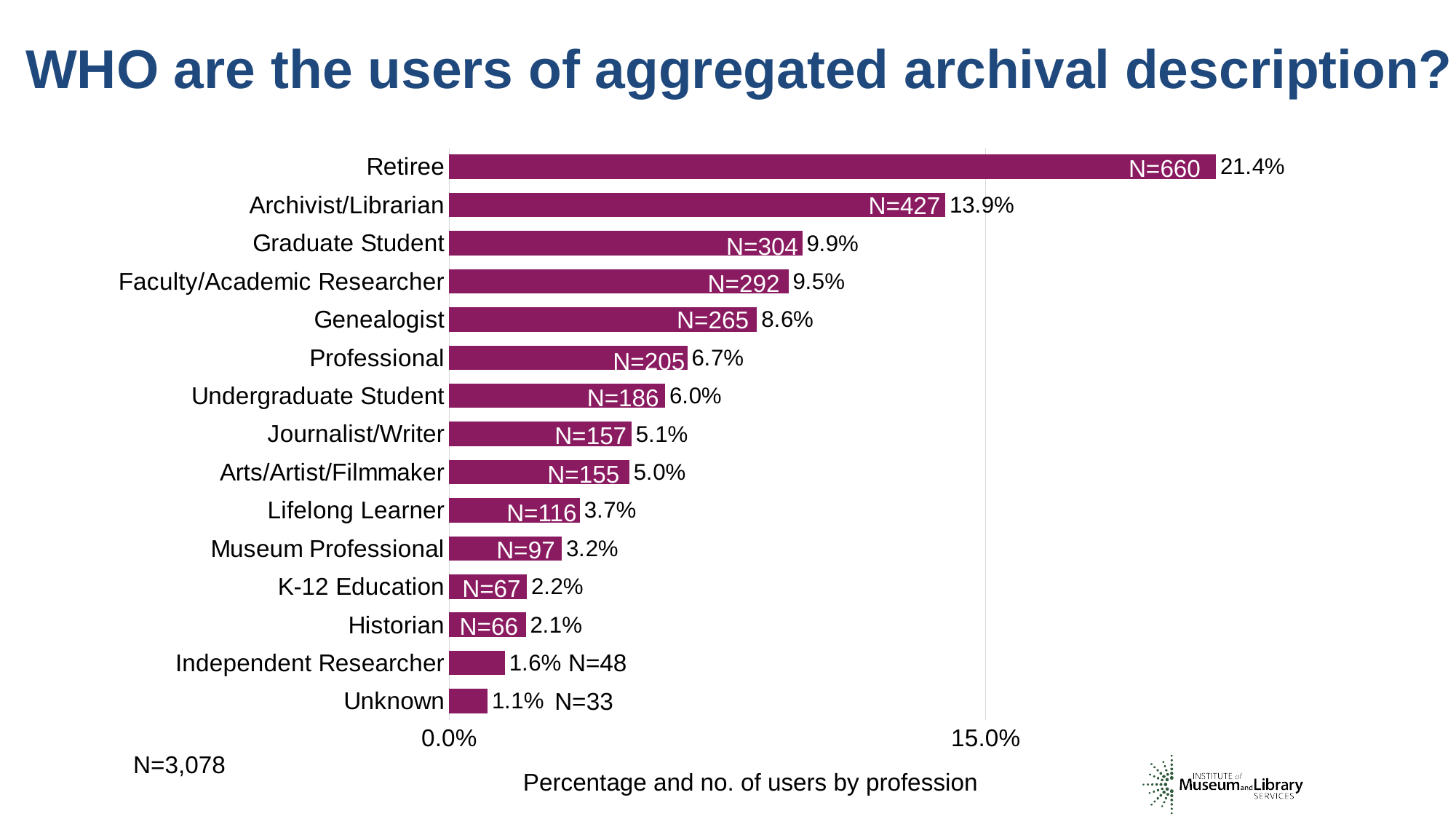
What percentage of users are Retirees? 21.4% Which profession has the lowest percentage of users? Unknown How many users (N) are Genealogists? N=265 What kind of chart is shown on the slide? Bar chart Which profession has the highest percentage of users? Retiree What percentage of users are Museum Professionals? 3.2% What is the difference in percentage between Retiree and Archivist/Librarian? 7.5% Which has a larger share of users, Graduate Student or Faculty/Academic Researcher? Graduate Student What is the caption below the x axis of the chart? Percentage and no. of users by profession How many professions are listed in the chart? 15 Is the value for Archivist/Librarian greater or less than 15.0%? less What is the total N shown at the bottom left of the chart? N=3,078